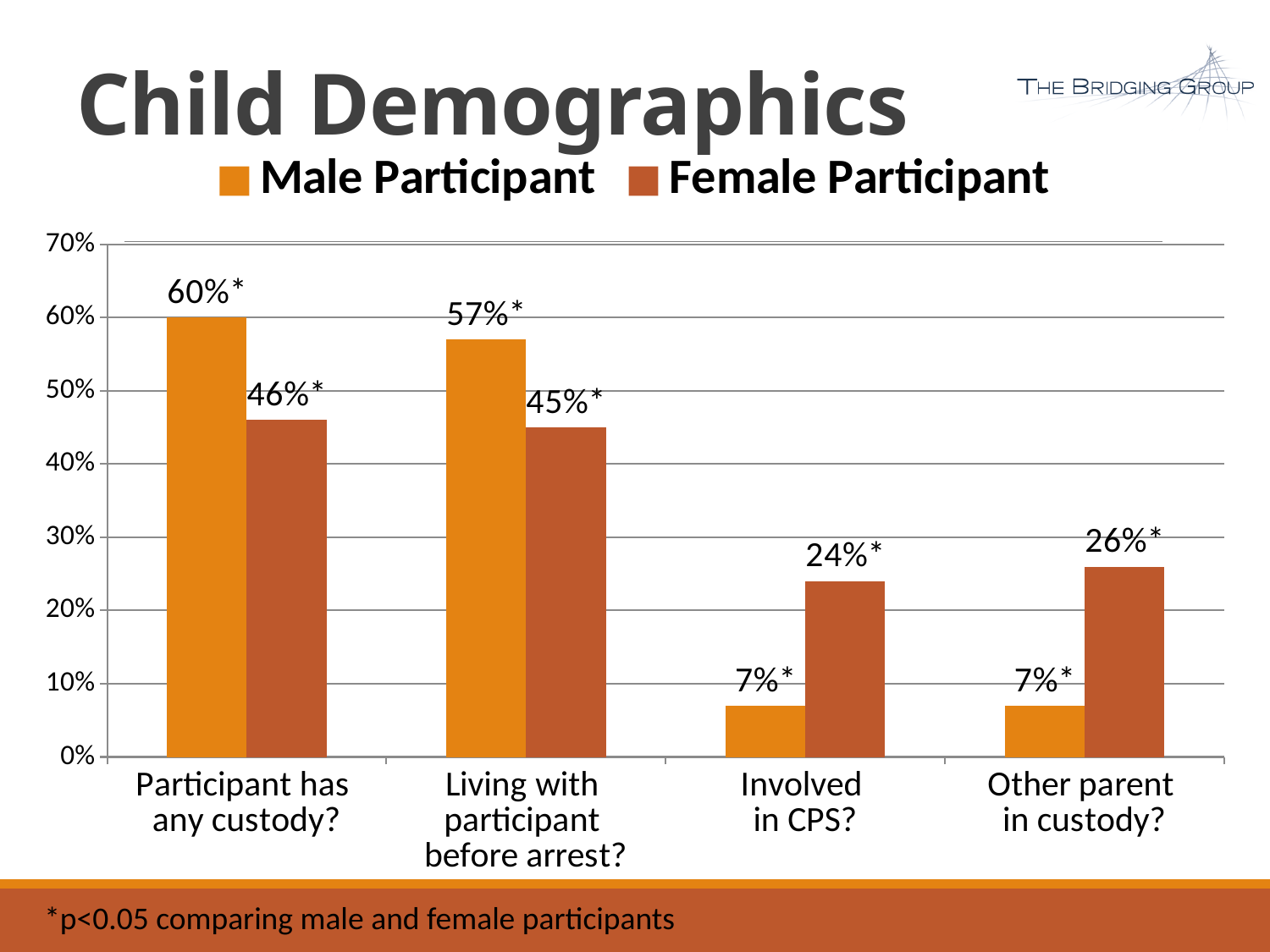
How many categories are shown on the x axis? 4 What is the difference between the Female Participant and Male Participant values for 'Other parent in custody?'? 19% Which category has the lowest Female Participant value? Involved in CPS? What is the value for Female Participant in the 'Involved in CPS?' category? 24% What is the difference between the Male Participant and Female Participant values for 'Participant has any custody?'? 14% Which is larger for 'Involved in CPS?': the Male Participant value or the Female Participant value? Female Participant Which category has the highest Male Participant value? Participant has any custody? What is the value for Female Participant in the 'Living with participant before arrest?' category? 45% How many series does the legend list? 2 What is the value for Male Participant in the 'Participant has any custody?' category? 60% What does the asterisk next to the data labels indicate, according to the footnote? p<0.05 comparing male and female participants What kind of chart is shown on the slide? Bar chart